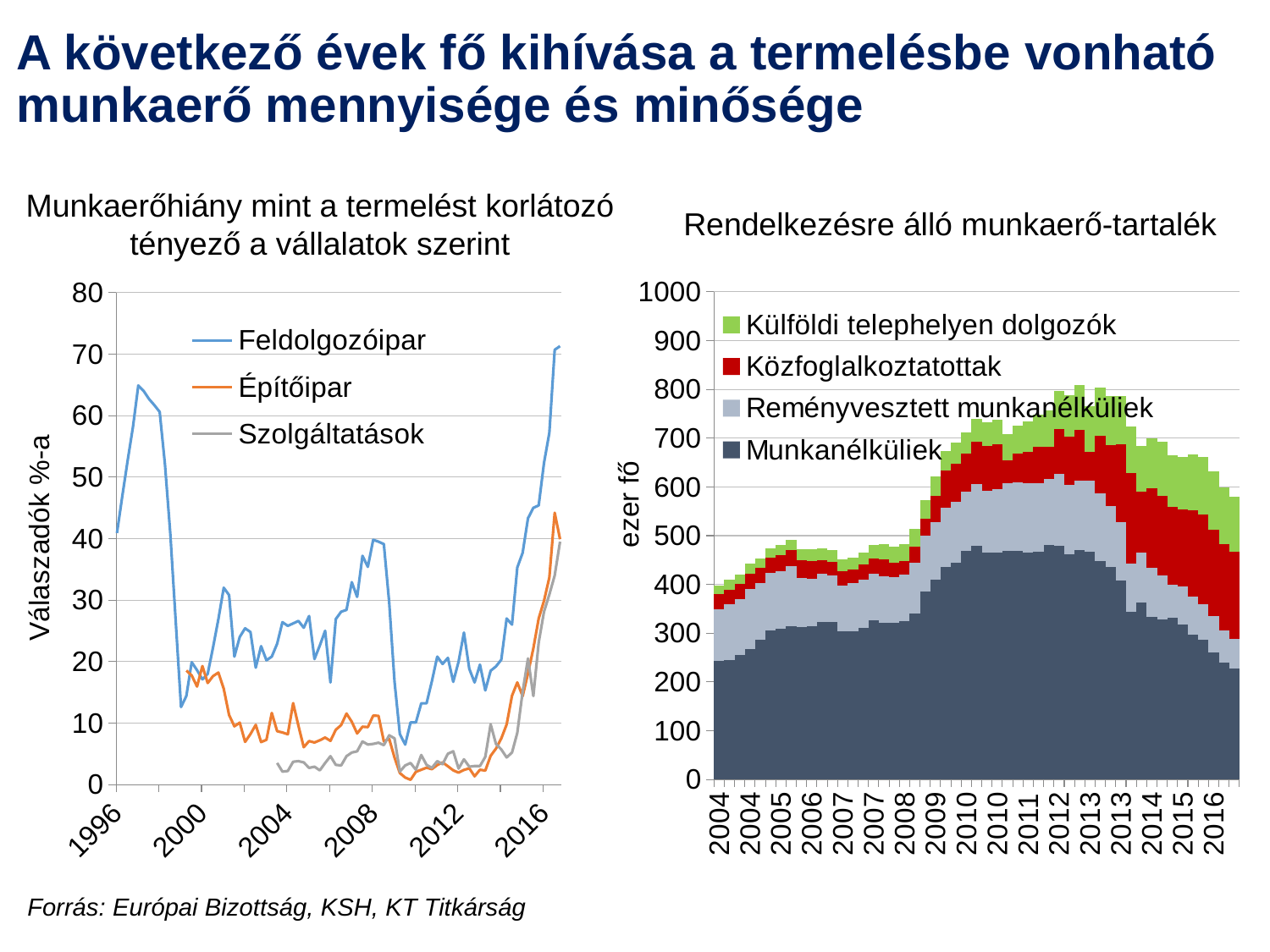
In the left chart, is the value for Feldolgozóipar at the end of the series (2017) greater or less than 60? greater In the left chart, which series has the higher value at the end of the series: Feldolgozóipar or Építőipar? Feldolgozóipar What kind of chart is the left chart, 'Munkaerőhiány mint a termelést korlátozó tényező a vállalatok szerint'? line chart In the right chart, is the Munkanélküliek value in the first bar (2004) greater or less than 300? less In the left chart, is the value for Építőipar at the end of the series greater or less than 30? greater What kind of chart is the right chart, 'Rendelkezésre álló munkaerő-tartalék'? stacked bar chart In the left chart, does the Feldolgozóipar series rise or fall between 2012 and 2016? rise How many series does the legend of the right chart list? 4 In the right chart, does the Munkanélküliek series rise or fall from 2013 to 2016? fall How many series does the legend of the left chart list? 3